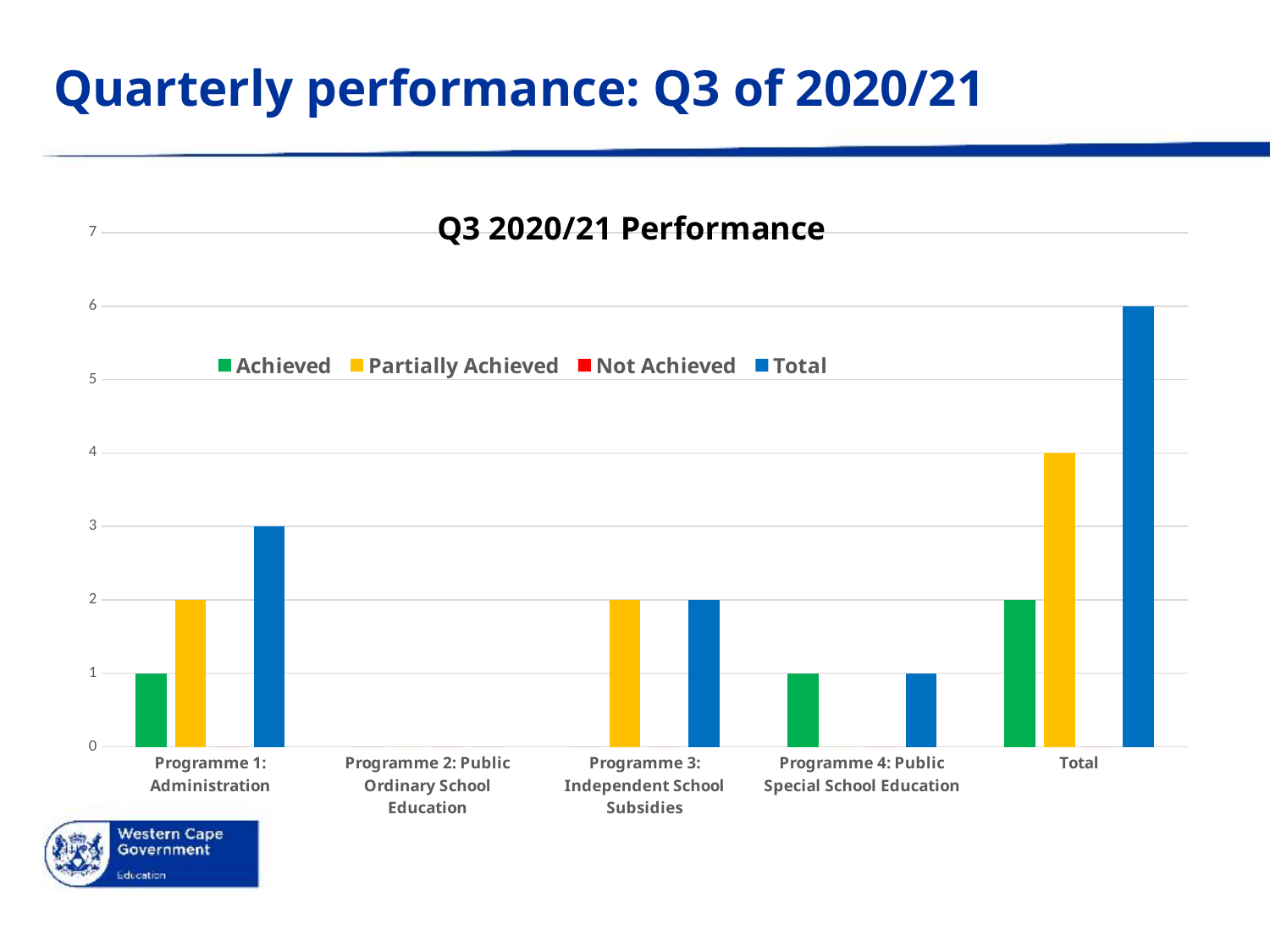
What is the title of the chart? Q3 2020/21 Performance What is the difference between the Partially Achieved and Achieved values in the Total category? 2 What is the Partially Achieved value for the Total category? 4 What is the Partially Achieved value for Programme 3: Independent School Subsidies? 2 Is the Total value for the Total category greater or less than 5? greater Which category has the highest Total value? Total How many series does the legend list? 4 Is the Total value for Programme 1: Administration larger than the Total value for Programme 3: Independent School Subsidies? Yes What type of chart is shown on the slide? bar chart What is the Total value for Programme 1: Administration? 3 What is the Achieved value for Programme 4: Public Special School Education? 1 How many categories are shown on the x axis? 5